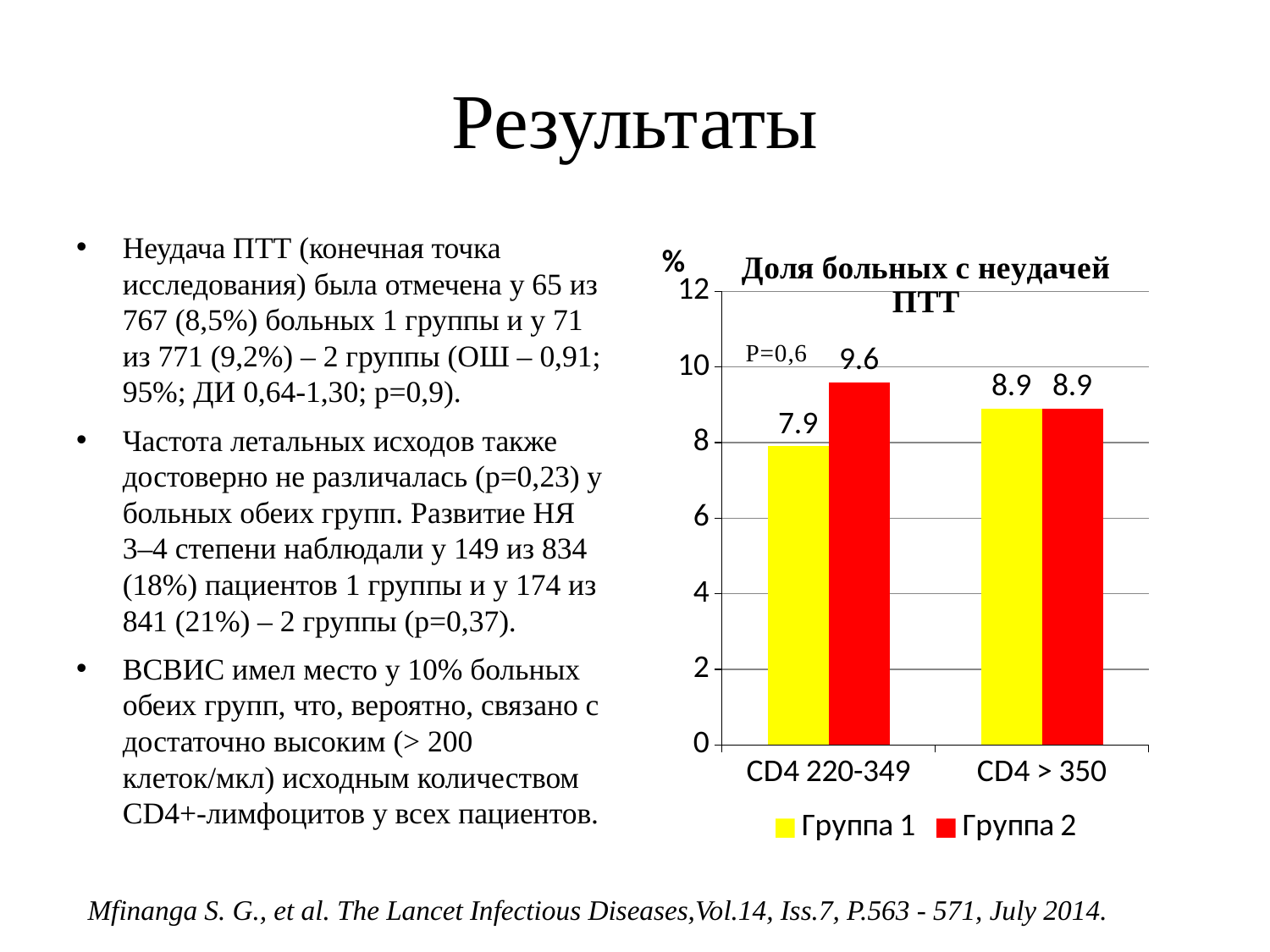
What kind of chart is shown on the slide? Bar chart What is the title of the chart? Доля больных с неудачей ПТТ In the CD4 220-349 category, which group has the larger value, Группа 1 or Группа 2? Группа 2 Which bar has the highest value on the chart? Группа 2, CD4 220-349 What is the value for Группа 2 in the CD4 > 350 category? 8.9 What is the value for Группа 1 in the CD4 220-349 category? 7.9 Which bar has the lowest value on the chart? Группа 1, CD4 220-349 What is the value for Группа 1 in the CD4 > 350 category? 8.9 How many series does the legend list? 2 How many categories are shown on the x axis? 2 What is the difference between Группа 2 and Группа 1 in the CD4 220-349 category? 1.7 What is the value for Группа 2 in the CD4 220-349 category? 9.6